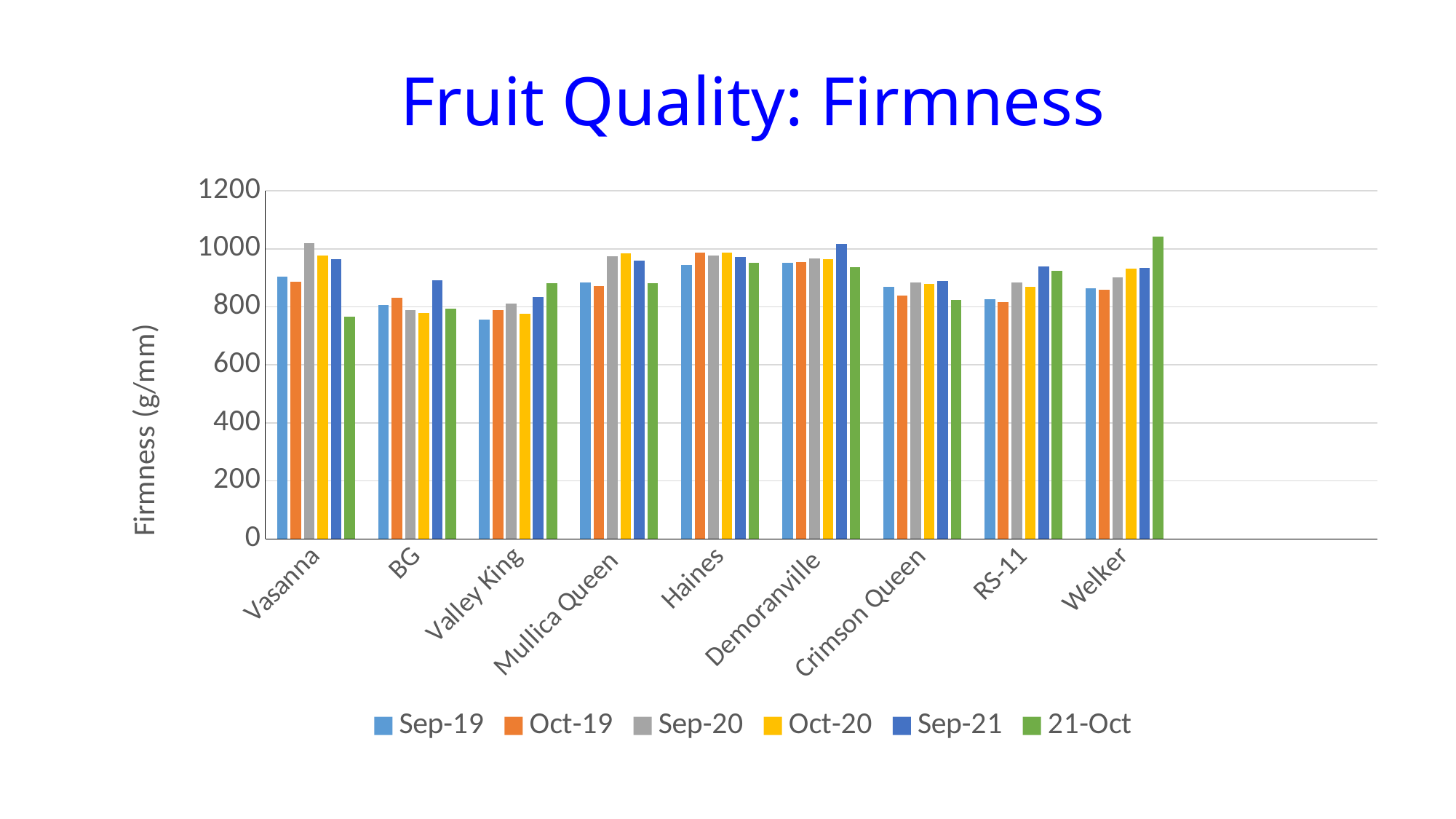
Which series has the lowest value for Vasanna? 21-Oct What is the title of the chart? Fruit Quality: Firmness Is the Sep-19 value for Valley King greater or less than 800? less Is the 21-Oct value for Welker greater or less than 1000? greater What kind of chart is shown on the slide? bar chart Is the Sep-21 value for Demoranville greater or less than 1000? greater For Vasanna, which is larger: the Sep-20 value or the 21-Oct value? Sep-20 Which series has the highest value for Welker? 21-Oct How many cultivars (categories) are shown on the x axis? 9 What is the label of the y axis? Firmness (g/mm) How many series does the legend list? 6